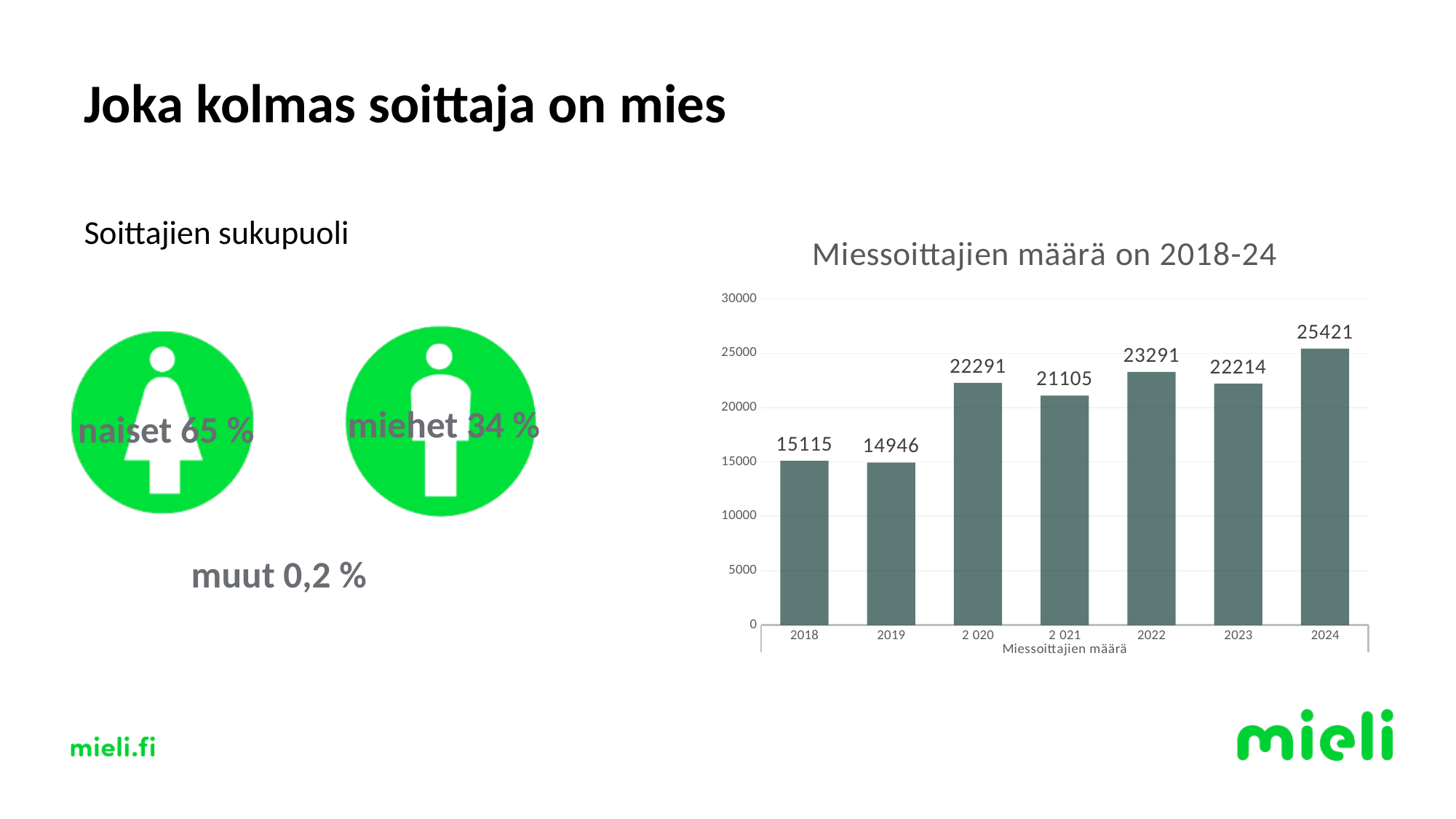
What is the value for 2018 in the chart 'Miessoittajien määrä on 2018-24'? 15115 What kind of chart is 'Miessoittajien määrä on 2018-24'? bar chart Which is larger in the chart 'Miessoittajien määrä on 2018-24', the value for 2020 or the value for 2021? 2020 What is the difference between the values for 2024 and 2018 in the chart 'Miessoittajien määrä on 2018-24'? 10306 What is the value for 2024 in the chart 'Miessoittajien määrä on 2018-24'? 25421 What is the title of the chart on the right side of the slide? Miessoittajien määrä on 2018-24 What is the difference between the values for 2022 and 2023 in the chart 'Miessoittajien määrä on 2018-24'? 1077 Which year has the highest value in the chart 'Miessoittajien määrä on 2018-24'? 2024 Is the value for 2023 greater or less than 20000 in the chart 'Miessoittajien määrä on 2018-24'? greater Which year has the lowest value in the chart 'Miessoittajien määrä on 2018-24'? 2019 How many years are shown in the chart 'Miessoittajien määrä on 2018-24'? 7 What is the value for 2021 in the chart 'Miessoittajien määrä on 2018-24'? 21105